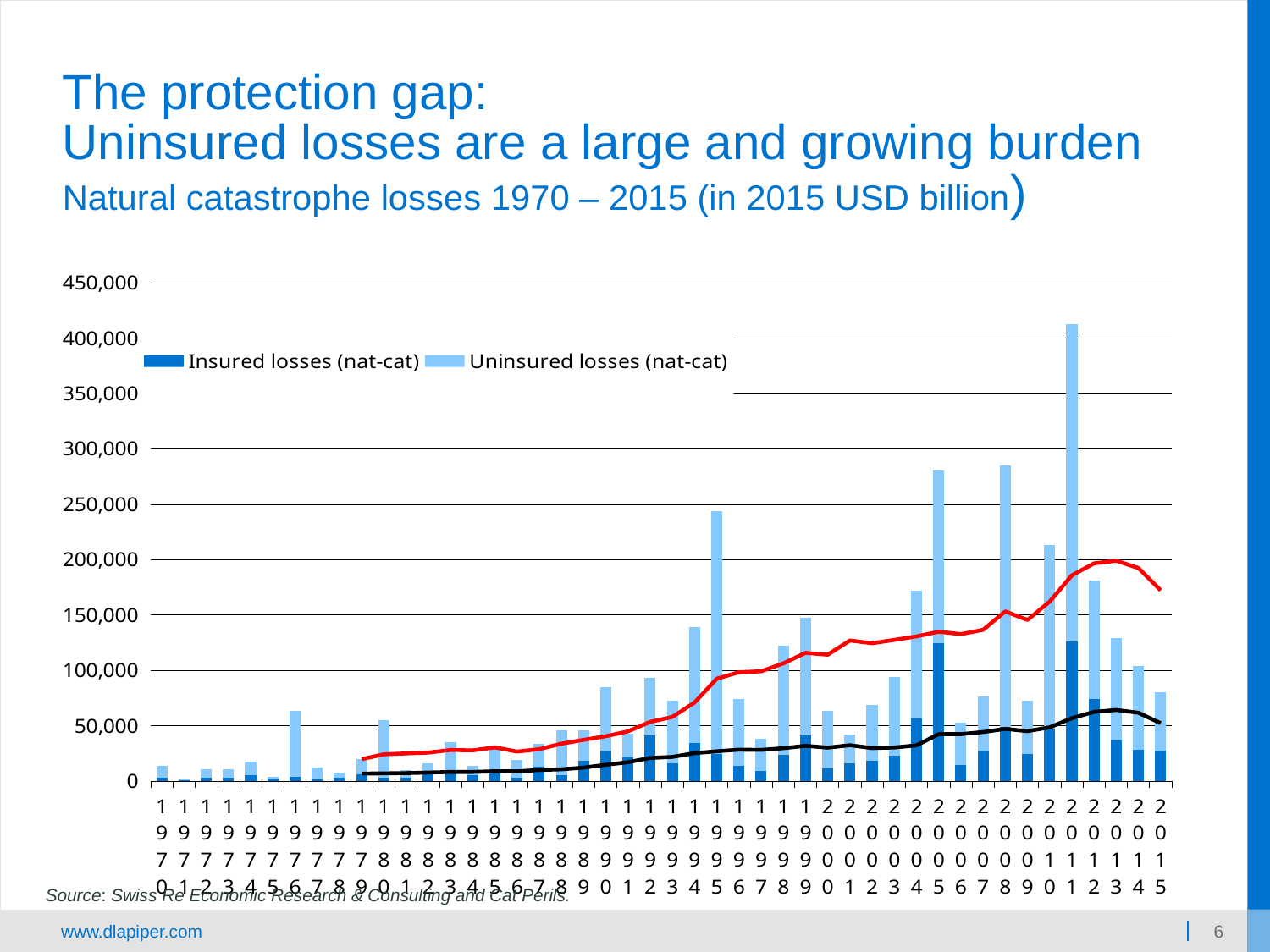
Is the total stacked bar for 1992 greater or less than 200,000? less Which year has the tallest stacked bar in the chart? 2011 Is the total stacked bar for 2005 greater or less than 250,000? greater Is the total stacked bar for 2011 greater or less than 350,000? greater What kind of chart is shown on the slide? Combination stacked bar and line chart What are the two series named in the legend? Insured losses (nat-cat) and Uninsured losses (nat-cat) How many series does the chart's legend list? 2 Which year has the larger total stacked bar, 1976 or 1975? 1976 How many years are plotted along the x axis of the chart? 46 Do the total losses generally rise or fall from 1970 to 2015 along the x axis? Rise Which year has the larger total stacked bar, 2011 or 2005? 2011